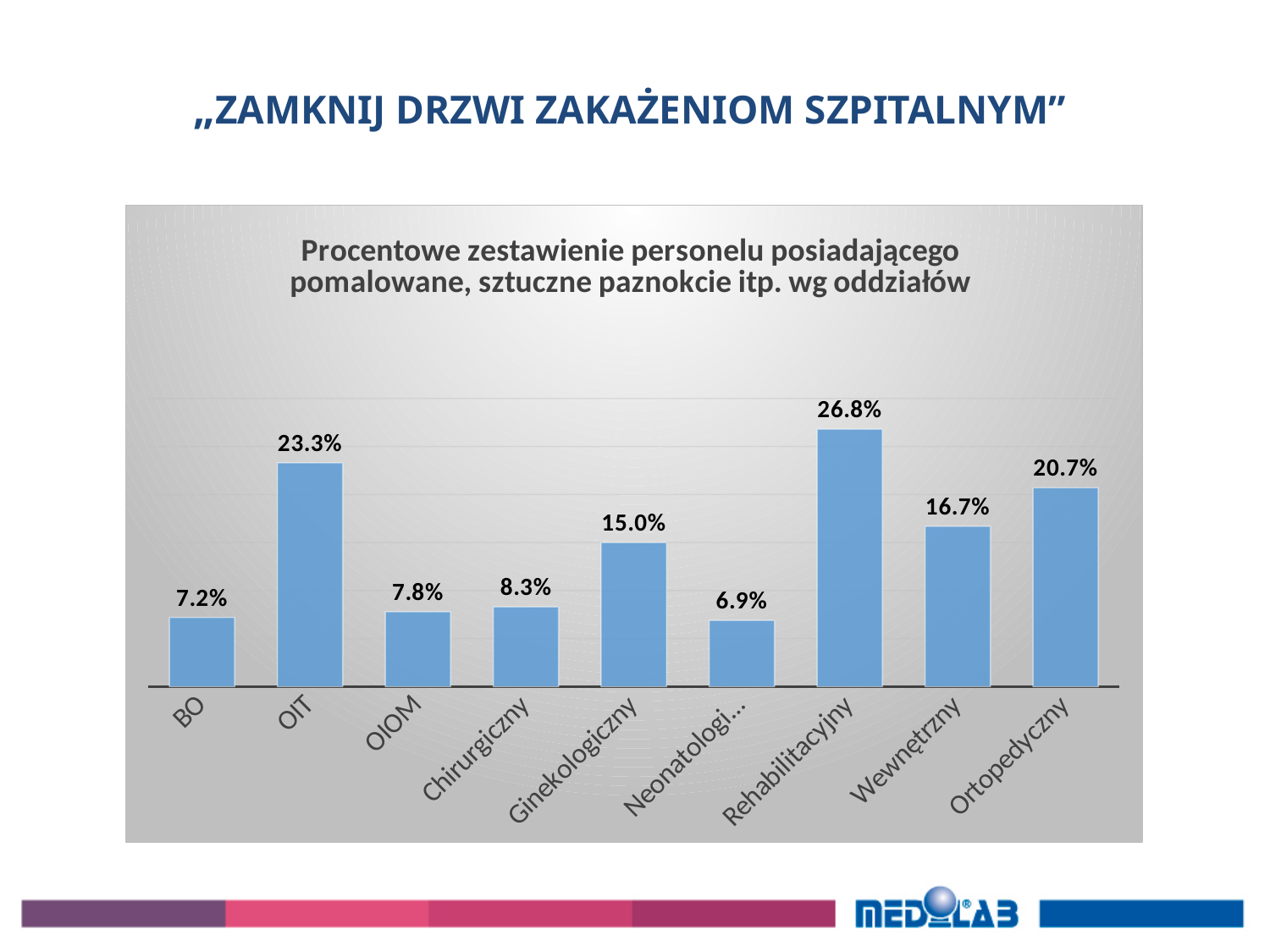
What kind of chart is shown on the slide? Bar chart What is the value for Ginekologiczny? 15.0% What is the title of the chart? Procentowe zestawienie personelu posiadającego pomalowane, sztuczne paznokcie itp. wg oddziałów What is the value for OIT? 23.3% How many categories are shown on the x axis? 9 Which is larger, the value for Chirurgiczny or the value for OIOM? Chirurgiczny Which category has the highest value? Rehabilitacyjny What is the value for Rehabilitacyjny? 26.8% What is the difference between the values for Rehabilitacyjny and OIT? 3.5% Which category has the lowest value? Neonatologi... What is the difference between the values for Ortopedyczny and Wewnętrzny? 4.0% What is the value for Wewnętrzny? 16.7%